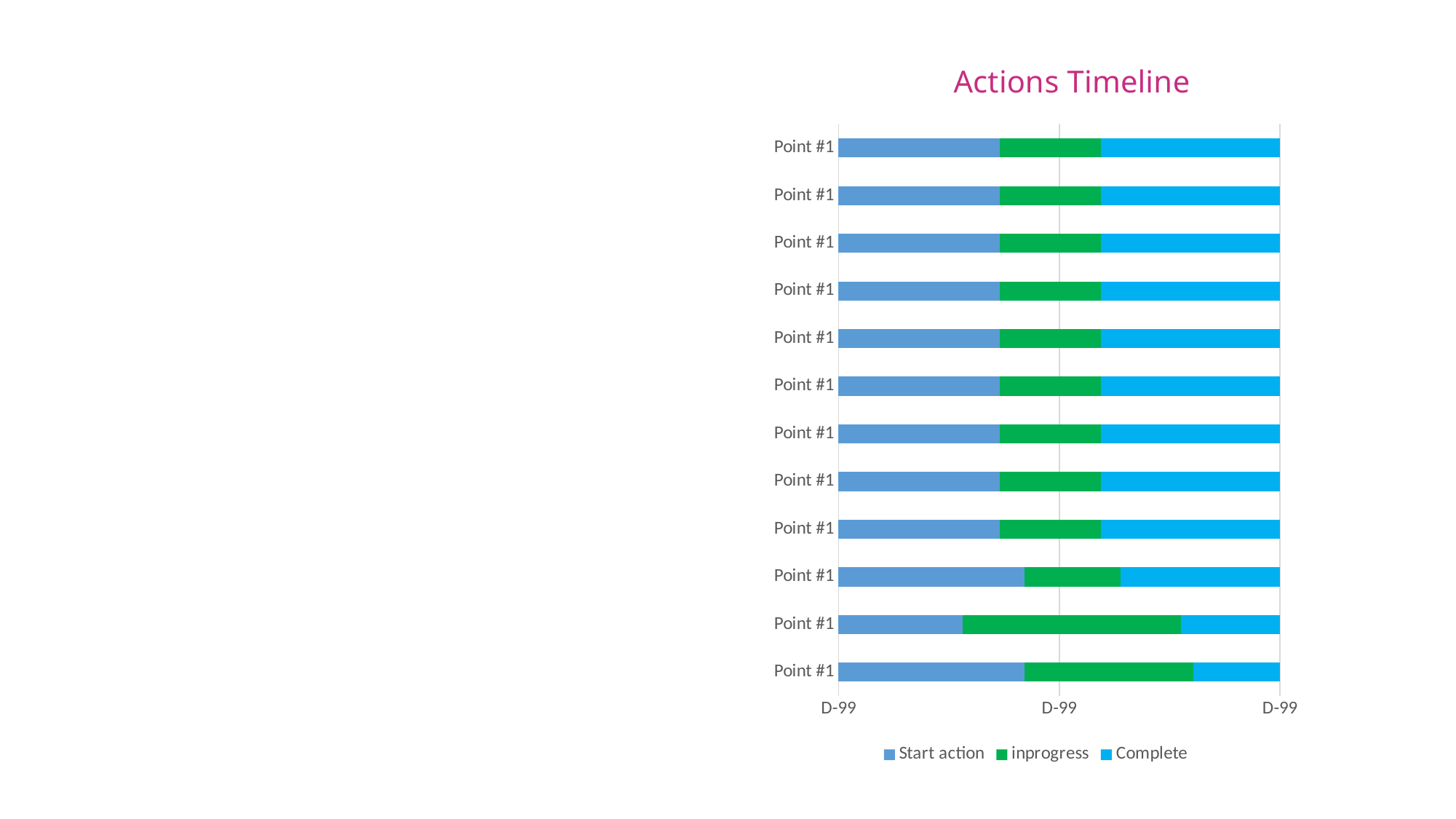
In the second bar from the bottom, which series has the largest segment? inprogress In the top bar, is the Complete segment larger or smaller than the inprogress segment? larger What kind of chart is shown on the slide? Stacked bar chart How many series does the legend list? 3 What are the three series named in the legend? Start action, inprogress, Complete What is the title of the chart? Actions Timeline How many bars (categories) are plotted in the chart? 12